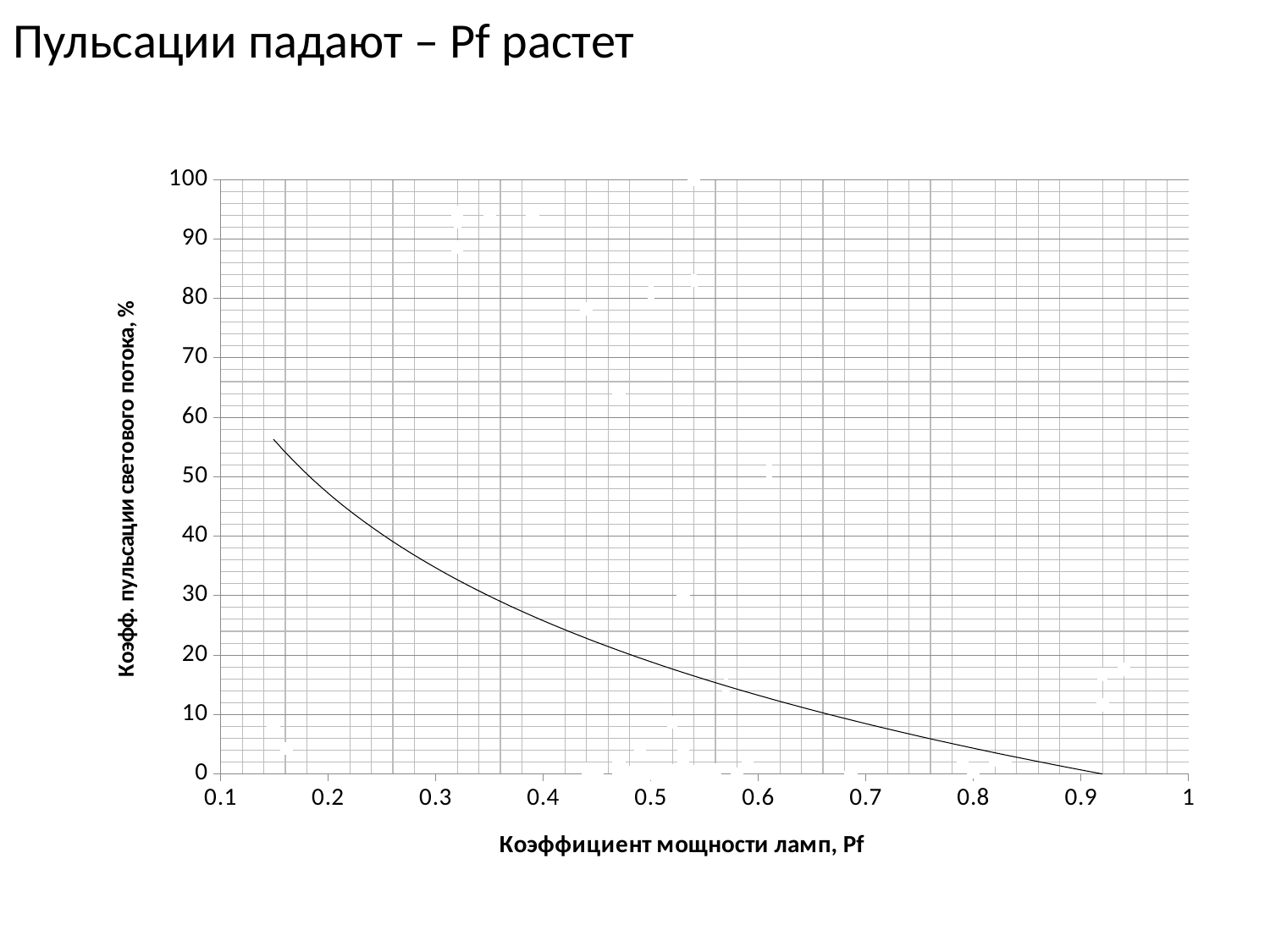
Is the pulsation coefficient at Pf = 0.7 greater or less than 20%? less What is the label of the x axis? Коэффициент мощности ламп, Pf Is the pulsation coefficient at Pf = 0.5 greater or less than 30%? less Is the pulsation coefficient at Pf = 0.2 greater or less than 40%? greater What kind of chart is shown on the slide? line chart Is the pulsation coefficient higher at Pf = 0.2 or at Pf = 0.6? Pf = 0.2 What is the title of the slide? Пульсации падают – Pf растет As the power factor Pf increases along the x axis, does the pulsation coefficient rise or fall? fall